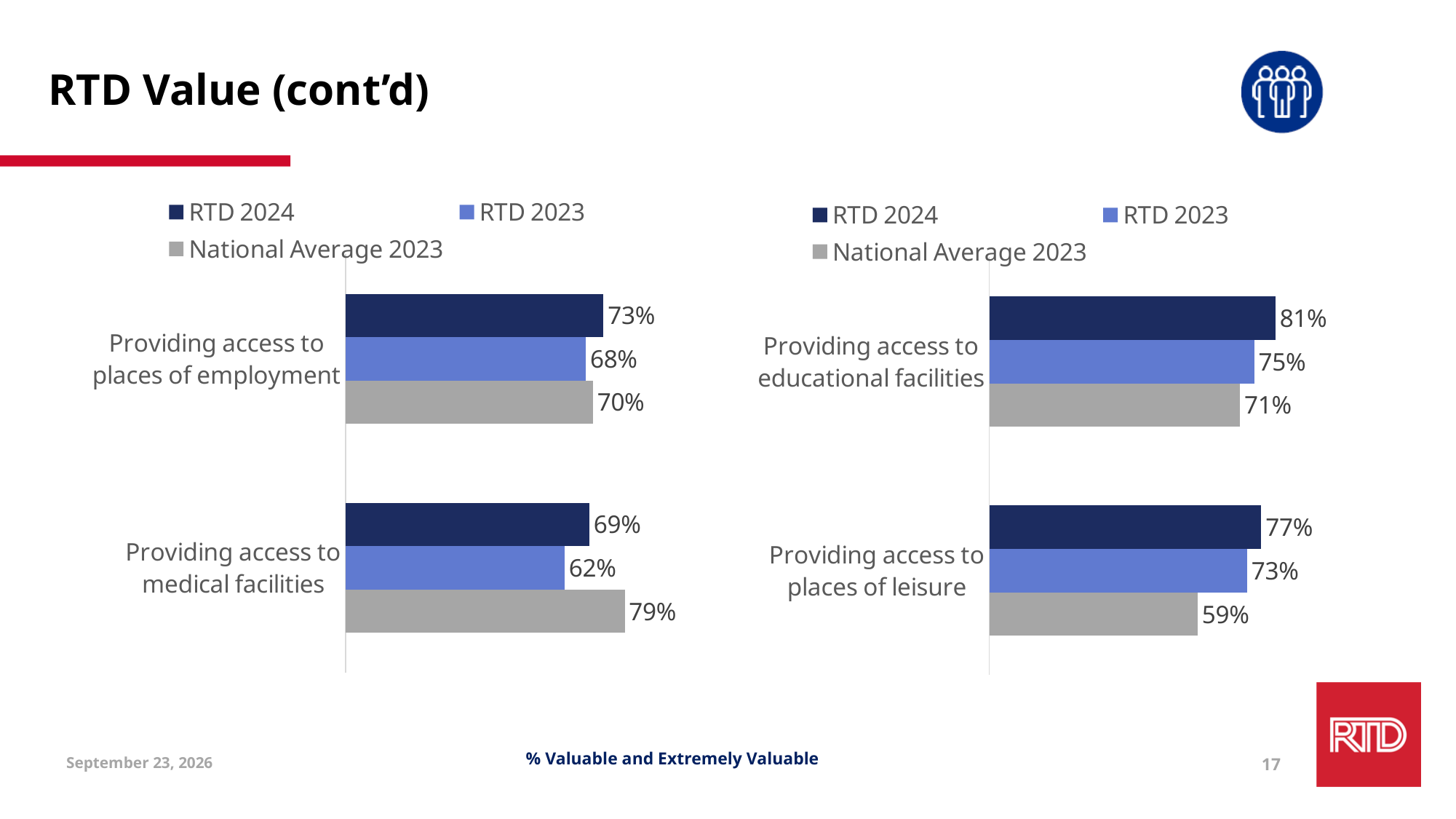
In the right chart, what is the difference between the RTD 2024 and National Average 2023 values for Providing access to places of leisure? 18% In the right chart, what is the National Average 2023 value for Providing access to places of leisure? 59% In the left chart, which is larger for Providing access to places of employment: RTD 2023 or National Average 2023? National Average 2023 In the right chart, which series has the highest value for Providing access to educational facilities? RTD 2024 How many categories does the right chart show? 2 How many series does the legend of the left chart list? 3 What type of chart is the left chart? Bar chart In the left chart, what is the RTD 2024 value for Providing access to places of employment? 73% In the left chart, which series has the lowest value for Providing access to medical facilities? RTD 2023 In the left chart, what is the difference between the RTD 2024 and RTD 2023 values for Providing access to medical facilities? 7% In the left chart, what is the National Average 2023 value for Providing access to medical facilities? 79% In the right chart, what is the RTD 2023 value for Providing access to educational facilities? 75%